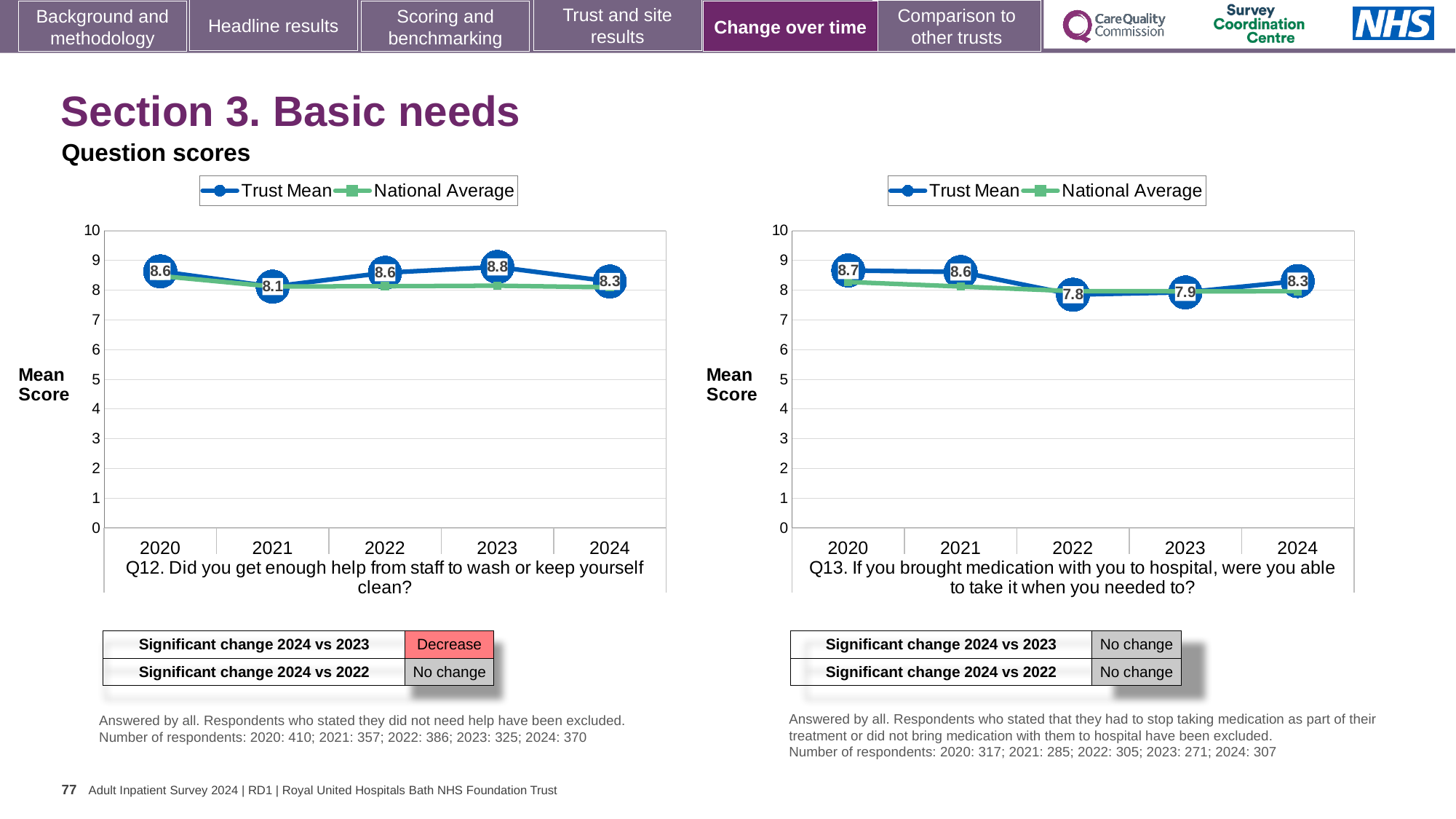
In the Q12 chart on the left, is the National Average for 2021 greater or less than 7? greater In the Q12 chart on the left, which year has the lowest Trust Mean? 2021 How many years are plotted on the x axis of the Q13 chart on the right? 5 What type of chart is the Q13 chart on the right? Line chart How many series does the legend of the Q12 chart on the left list? 2 In the Q13 chart on the right, is the Trust Mean higher in 2021 or in 2024? 2021 In the Q13 chart on the right, which year has the highest Trust Mean? 2020 In the Q12 chart on the left, what is the Trust Mean for 2023? 8.8 In the Q13 chart on the right, does the Trust Mean rise or fall from 2020 to 2022? Fall In the Q13 chart on the right, what is the difference between the Trust Mean in 2020 and in 2022? 0.9 In the Q13 chart on the right, what is the Trust Mean for 2022? 7.8 In the Q12 chart on the left, what is the difference between the Trust Mean in 2023 and in 2024? 0.5